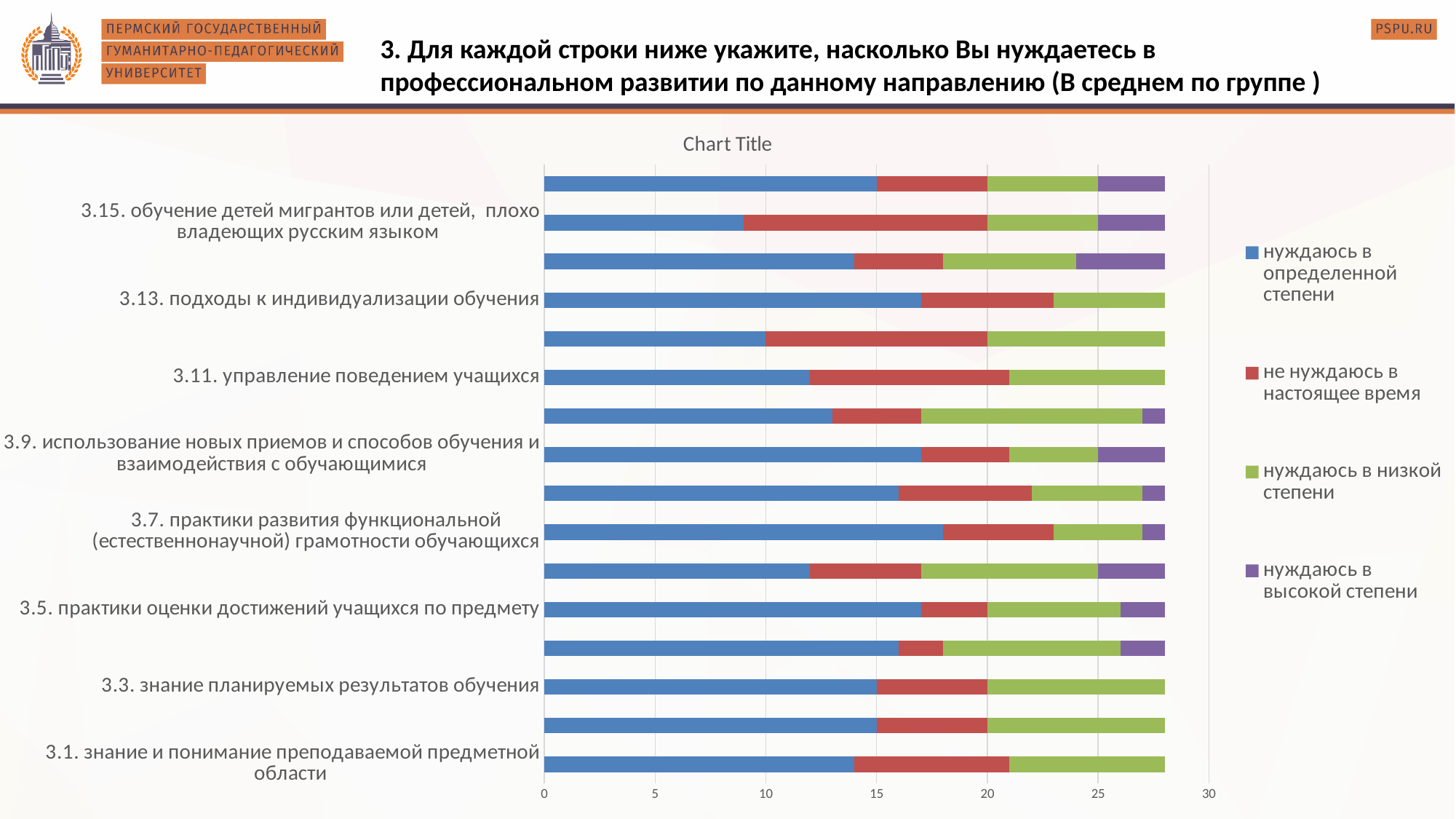
What colour represents 'нуждаюсь в высокой степени' in the legend? purple What kind of chart is shown on the slide? stacked bar chart Is the value of the 'нуждаюсь в определенной степени' segment for '3.13. подходы к индивидуализации обучения' greater or less than 15? greater Which has a larger 'нуждаюсь в определенной степени' segment: '3.7. практики развития функциональной (естественнонаучной) грамотности обучающихся' or '3.11. управление поведением учащихся'? 3.7. практики развития функциональной (естественнонаучной) грамотности обучающихся Is the value of the 'нуждаюсь в определенной степени' segment for '3.1. знание и понимание преподаваемой предметной области' greater or less than 15? less Is the total length of the bar for '3.1. знание и понимание преподаваемой предметной области' greater or less than 25? greater How many series does the legend list? 4 How many bars are plotted in the chart? 16 What is the title shown above the chart? Chart Title Which has a larger 'нуждаюсь в определенной степени' segment: '3.11. управление поведением учащихся' or '3.13. подходы к индивидуализации обучения'? 3.13. подходы к индивидуализации обучения